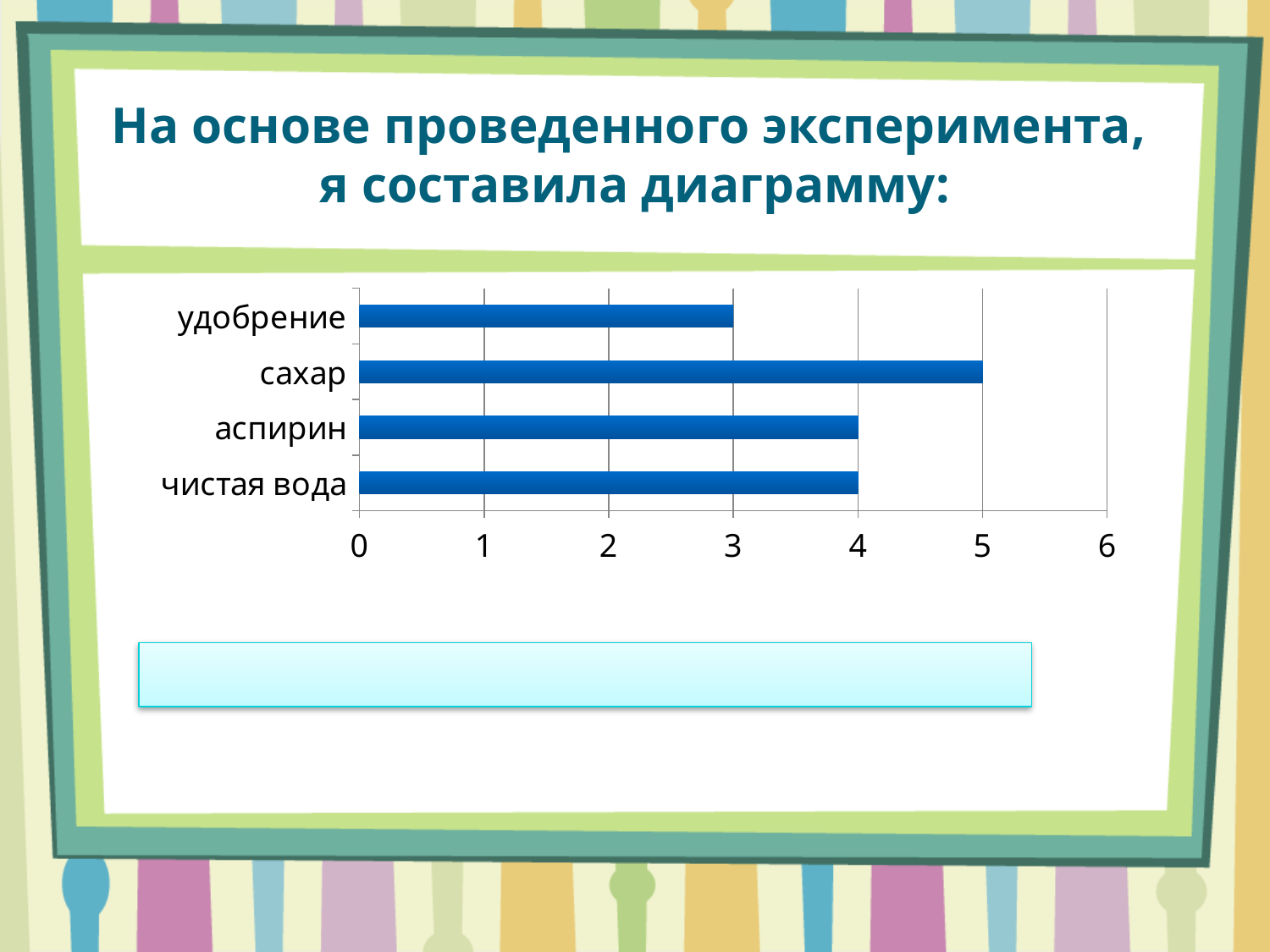
Which category has the highest value? сахар What is the value for сахар? 5 What is the value for аспирин? 4 What type of chart is shown on the slide? bar chart What is the maximum value shown on the horizontal axis? 6 Which category has the lowest value? удобрение Is the value for удобрение greater or less than 4? less What is the value for удобрение? 3 How many categories are plotted in the chart? 4 What is the value for чистая вода? 4 What is the difference between the values for сахар and удобрение? 2 Which is larger, the value for сахар or the value for аспирин? сахар